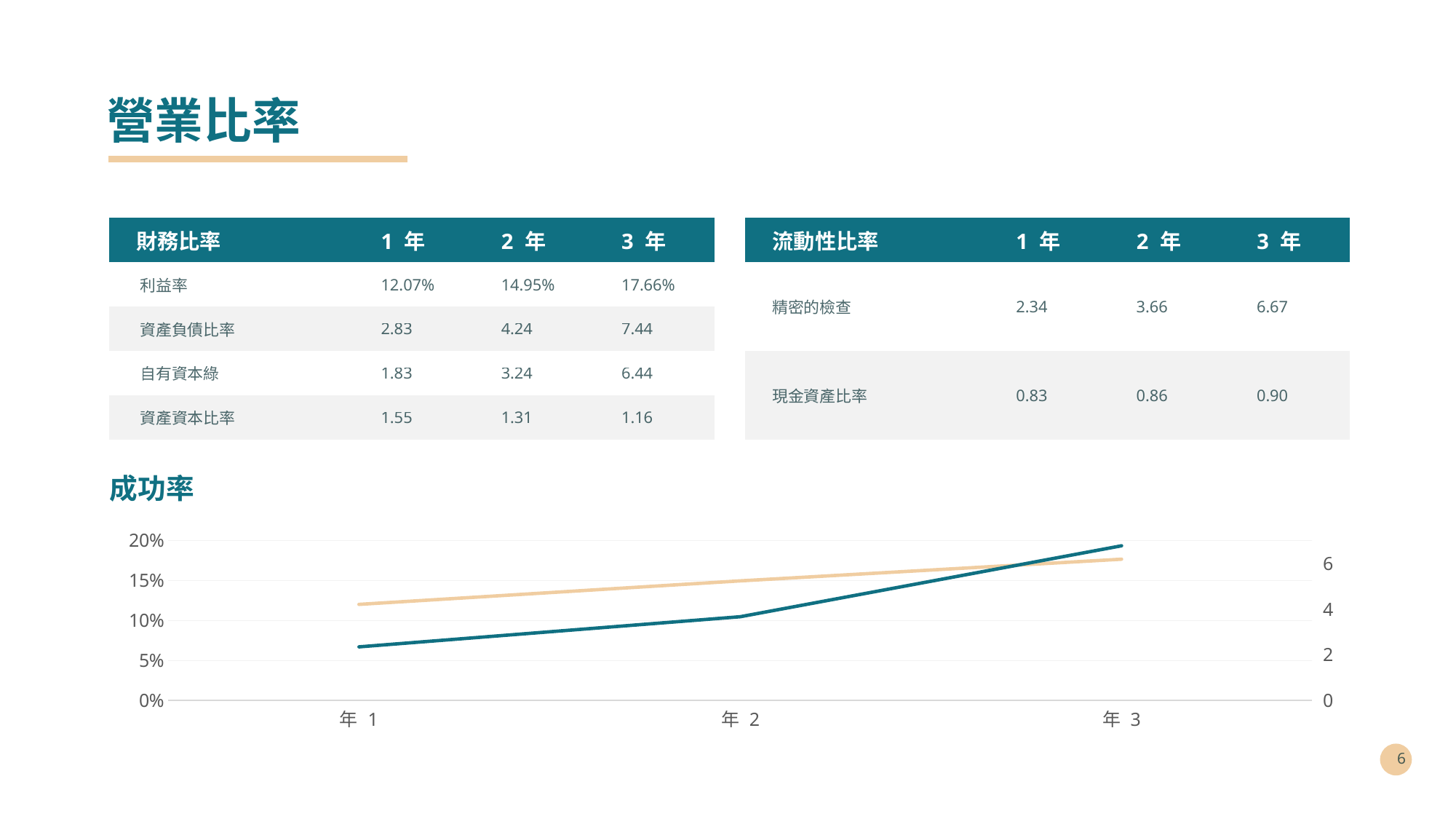
In the 成功率 chart, is the tan line's value at 年 3 greater or less than 15% on the left axis? greater In the 成功率 chart, does the dark teal line rise or fall from 年 1 to 年 3? rise What kind of chart is shown under the heading 成功率? line chart In the 成功率 chart, is the tan line's value at 年 1 greater or less than 10% on the left axis? greater What is the highest tick label on the left axis of the 成功率 chart? 20% In the 成功率 chart, does the tan (light) line rise or fall from 年 1 to 年 3? rise What is the title of the line chart on the slide? 成功率 In the 成功率 chart, is the dark teal line's value at 年 3 greater or less than 6 on the right axis? greater How many points along the x axis does the 成功率 chart have? 3